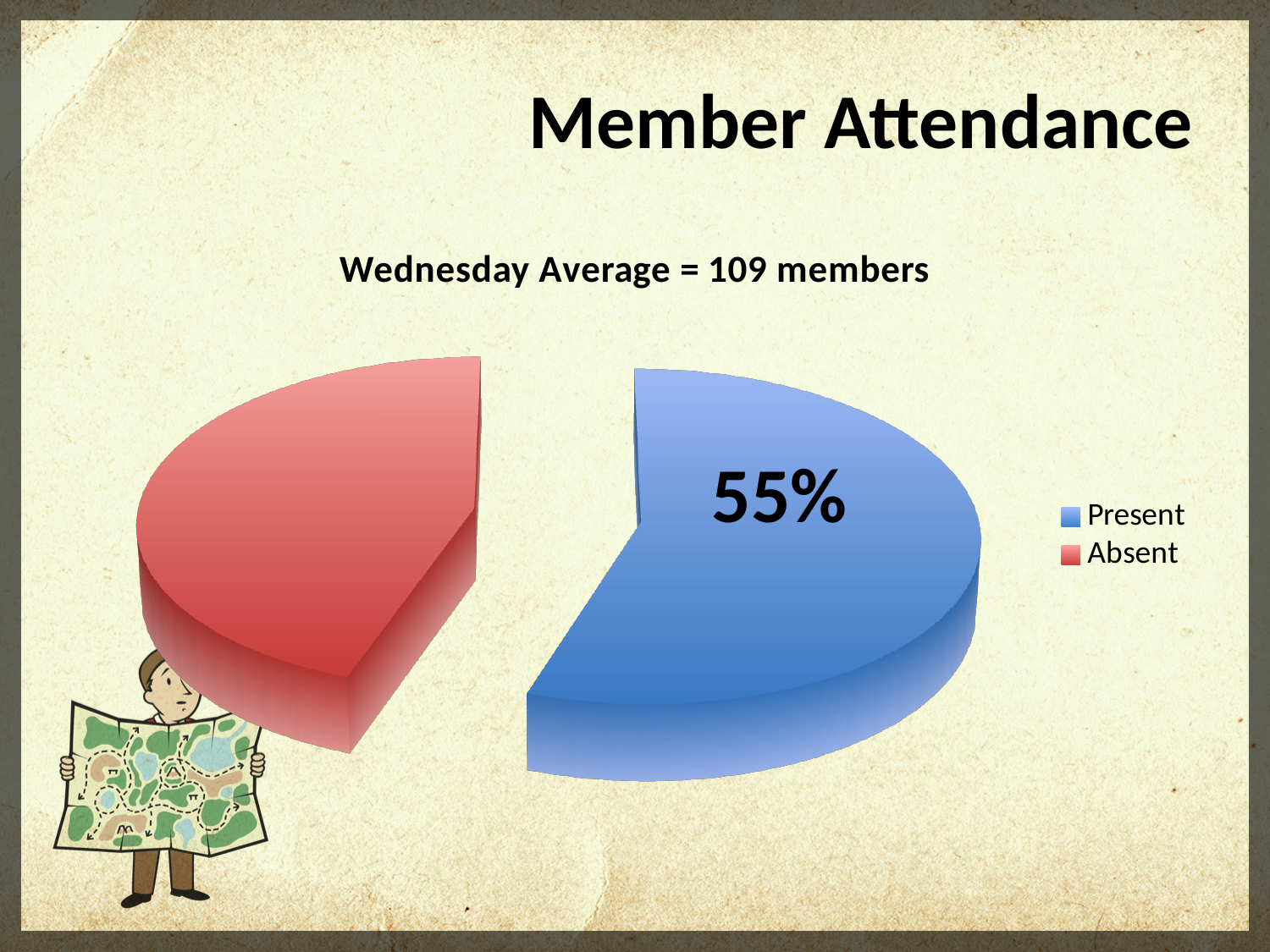
Which category has the largest slice of the pie chart? Present What colour is the Present slice in the pie chart? blue Which category has the smallest slice of the pie chart? Absent According to the chart title, what is the Wednesday average number of members? 109 members What kind of chart is shown on the slide? pie chart How many entries does the chart legend list? 2 What share of the pie does the Present slice take? 55% How many slices does the pie chart have? 2 What percentage of members are shown as Present in the pie chart? 55% Which slice is larger, Present or Absent? Present What is the title shown above the pie chart? Wednesday Average = 109 members